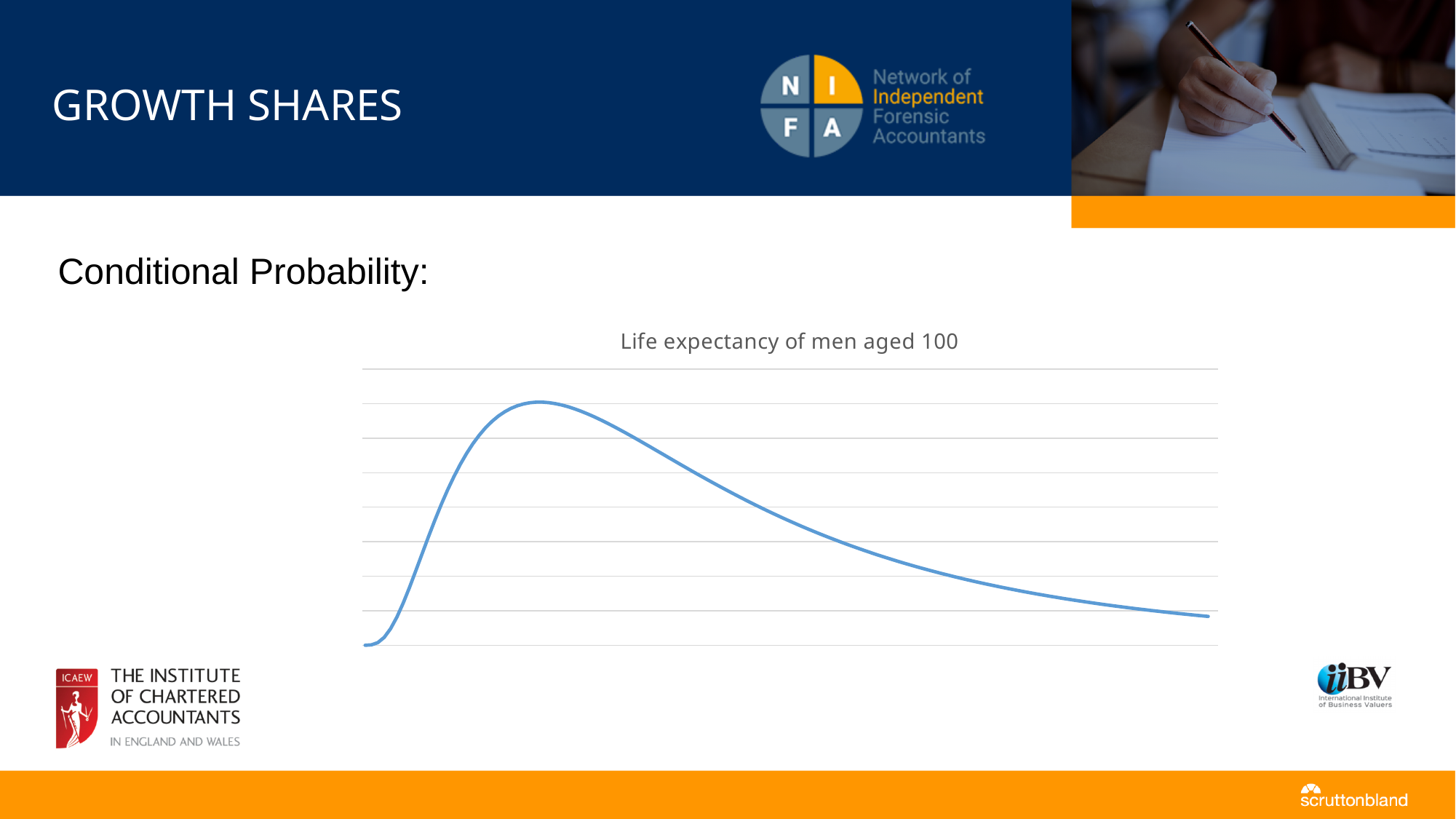
Moving from left to right along the x axis, does the line rise throughout, fall throughout, or rise and then fall? rise and then fall What kind of chart is shown on the slide? line chart Is the peak of the line located in the left half or the right half of the chart? left half What is the title of the chart? Life expectancy of men aged 100 After reaching its peak, does the line rise or fall towards the right end of the chart? fall